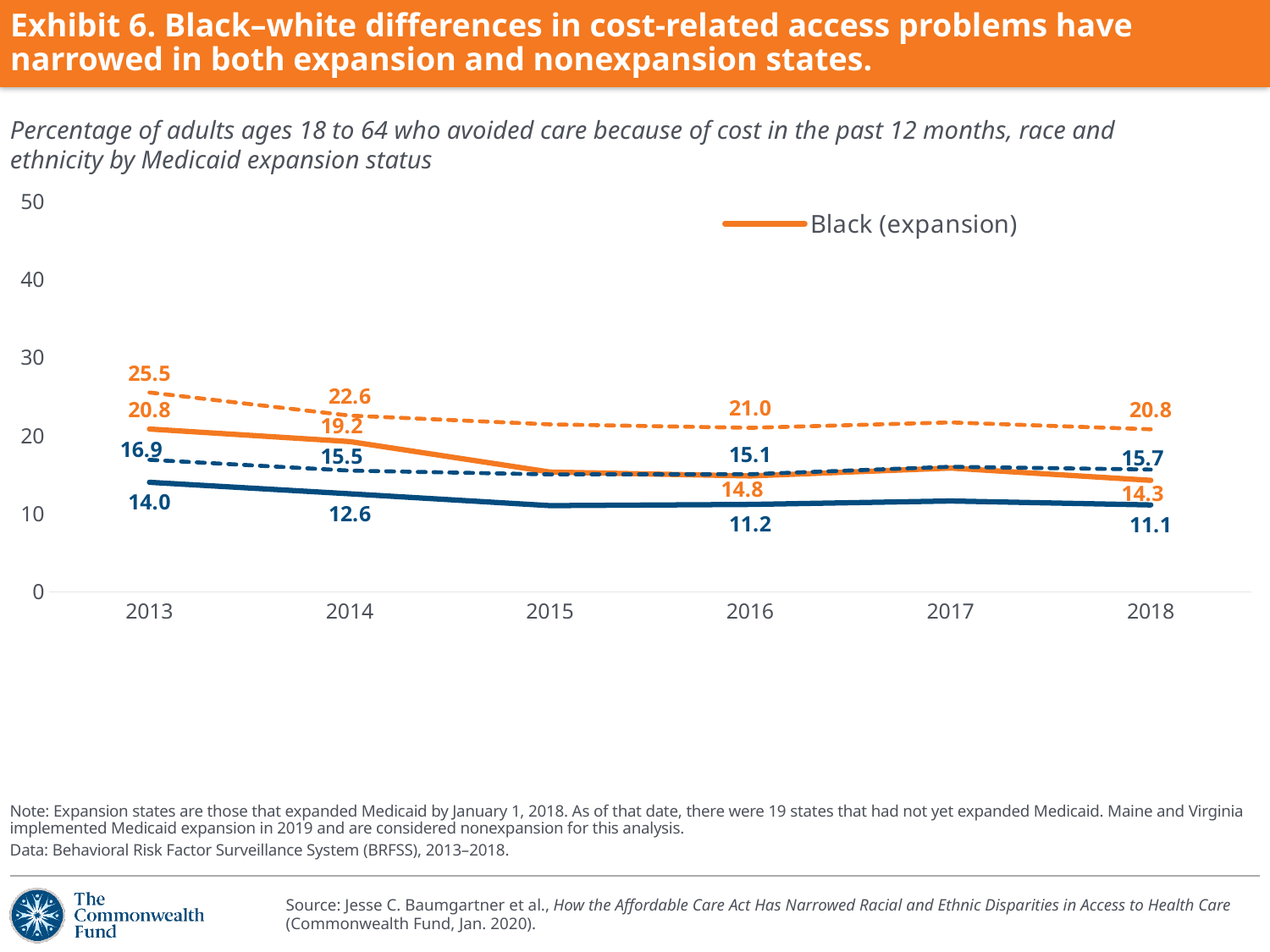
Which year has the highest value for Black (expansion)? 2013 What kind of chart is shown on the slide? line chart What is the value for Black (expansion) in 2018? 14.3 What is the value for Black (expansion) in 2014? 19.2 Which series is named in the chart's legend? Black (expansion) Is the value for Black (expansion) in 2015 greater or less than 20? less How many years are shown along the x axis of the chart? 6 What is the value for Black (expansion) in 2013? 20.8 Does the Black (expansion) line rise or fall from 2013 to 2018? fall By how much did the Black (expansion) value fall from 2013 to 2018? 6.5 What is the value for Black (expansion) in 2016? 14.8 How many series does the chart's legend list? 1